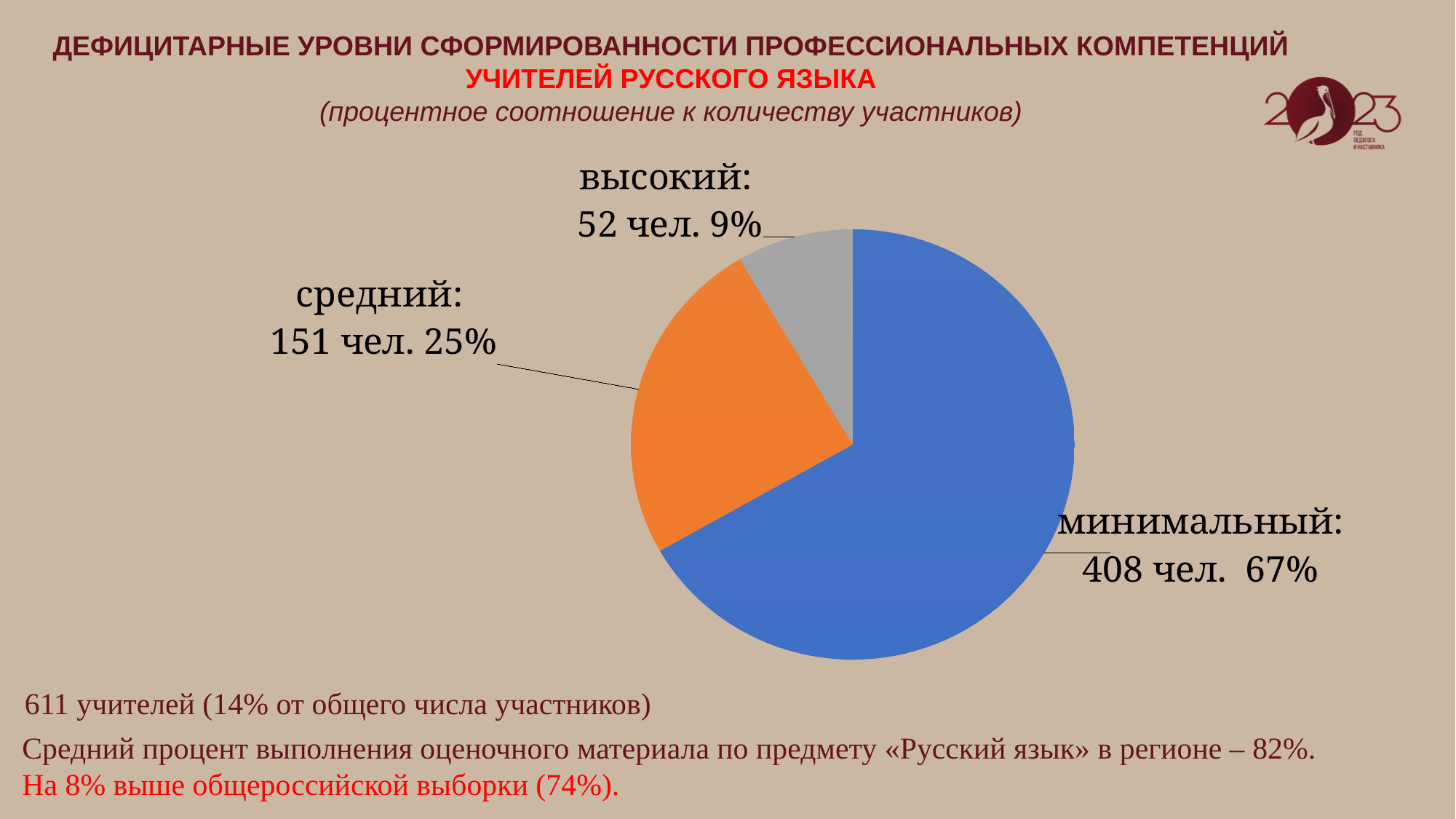
What colour is the 'минимальный' slice? blue What percentage share does the 'высокий' slice have? 9% Which category has more people, 'средний' or 'высокий'? средний How many slices does the pie chart have? 3 What is the total number of people across all three slices? 611 How many people are in the 'минимальный' category? 408 чел. Which category has the smallest slice of the pie? высокий Which category has the largest slice of the pie? минимальный What percentage share does the 'средний' slice have? 25% What kind of chart is shown on the slide? pie chart How many people are in the 'высокий' category? 52 чел. What is the difference in number of people between the 'средний' and 'высокий' categories? 99 чел.